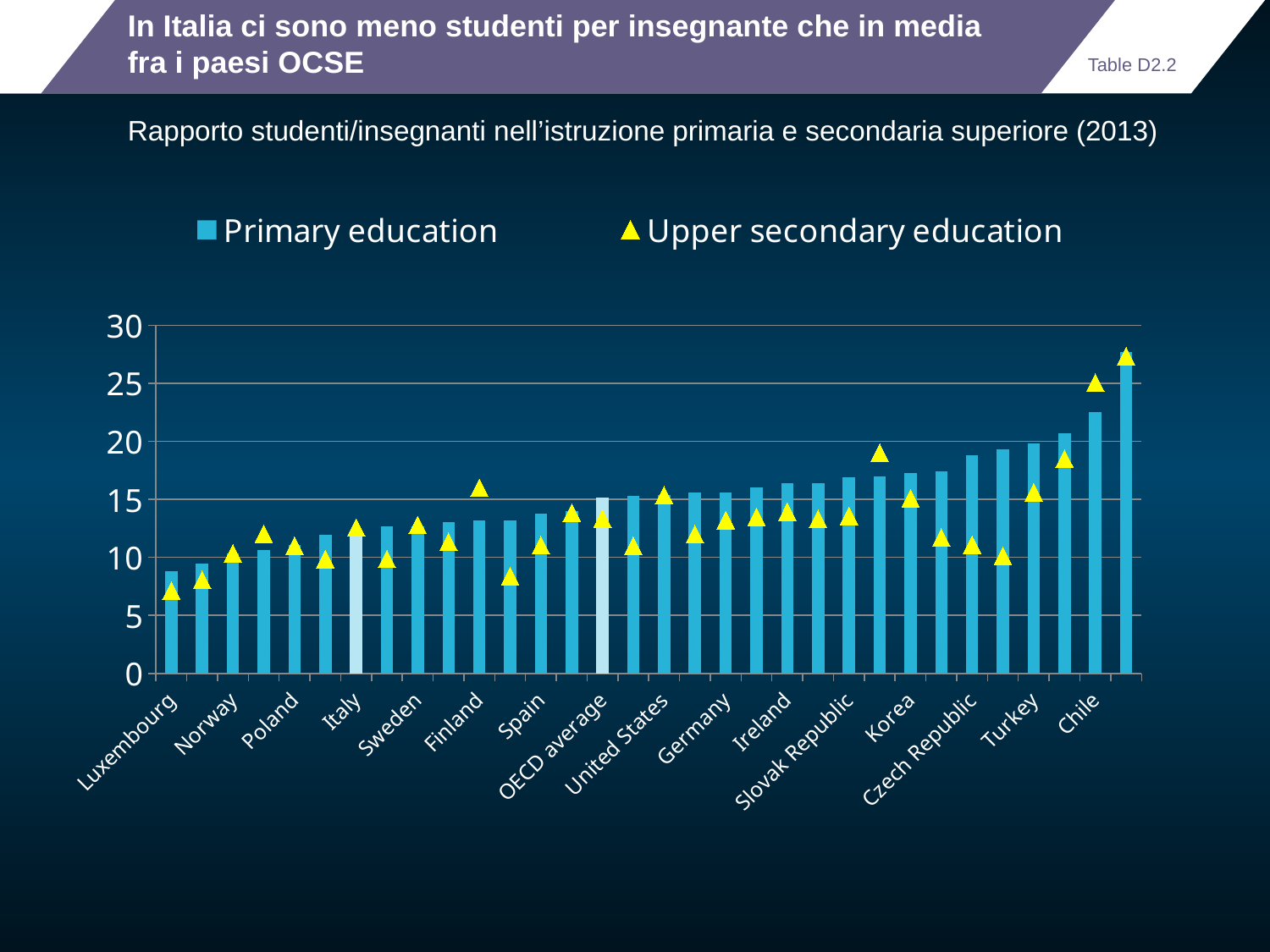
Which country has the lowest Primary education student/teacher ratio? Luxembourg Do the Primary education bars rise or fall from left to right along the x axis? rise Which series is represented by the yellow triangle markers? Upper secondary education Is the Primary education value for Italy greater or less than 15? less Is the Upper secondary education value for Luxembourg greater or less than 10? less How many series does the legend list? 2 Is the Primary education value for Chile greater or less than 25? less What kind of chart is shown on the slide? bar chart Which is larger, the Primary education value for Italy or for Korea? Korea